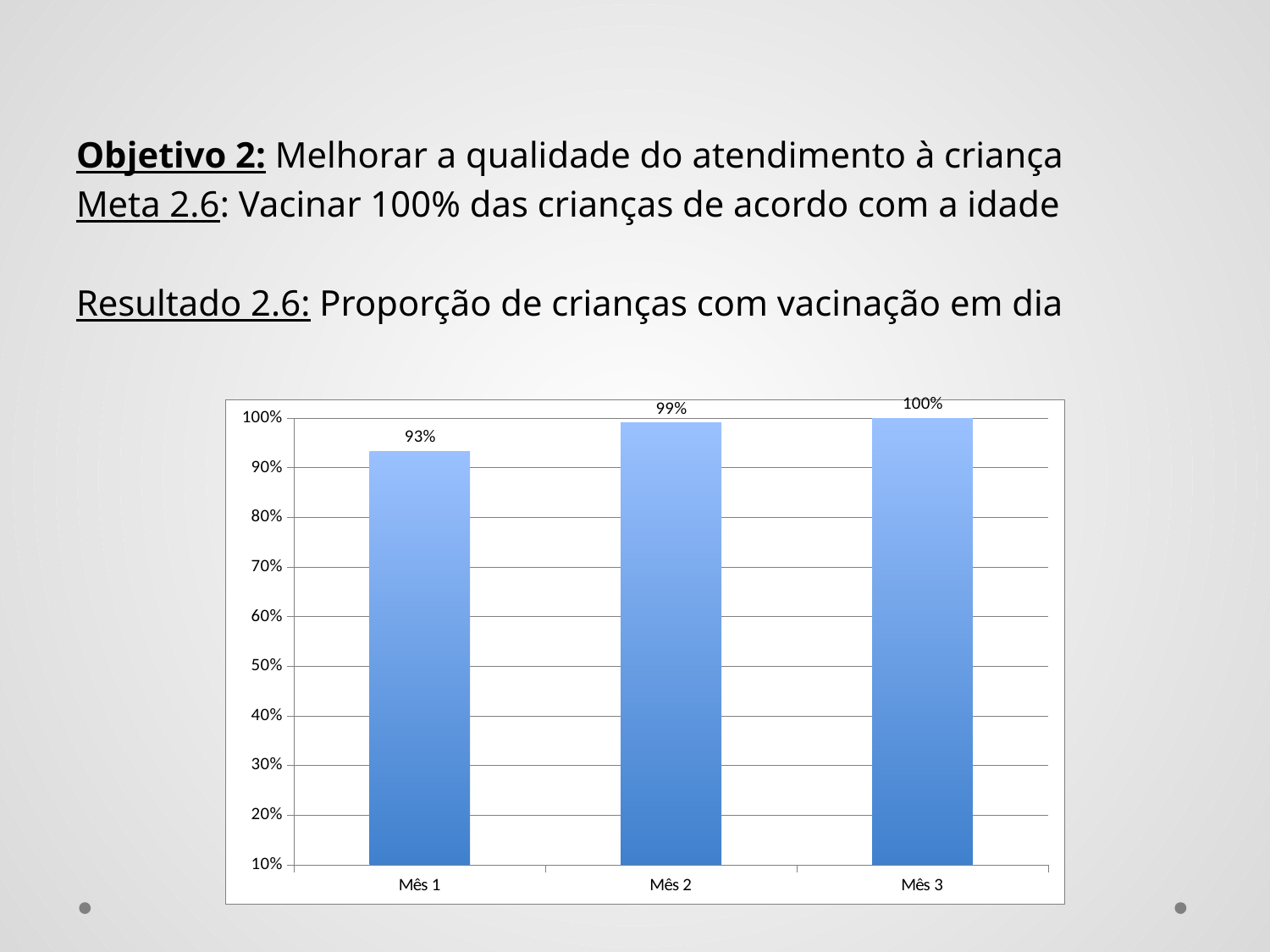
What kind of chart is shown on the slide? bar chart What is the value for Mês 2? 99% Which is larger, the value for Mês 1 or the value for Mês 2? Mês 2 What is the value for Mês 1? 93% What is the difference between the values for Mês 2 and Mês 1? 6% How many categories are shown on the x axis? 3 Which month has the lowest value? Mês 1 Which month has the highest value? Mês 3 Do the values rise or fall from Mês 1 to Mês 3? rise What is the value for Mês 3? 100% What is the difference between the values for Mês 3 and Mês 1? 7% Is the value for Mês 1 greater or less than 90%? greater